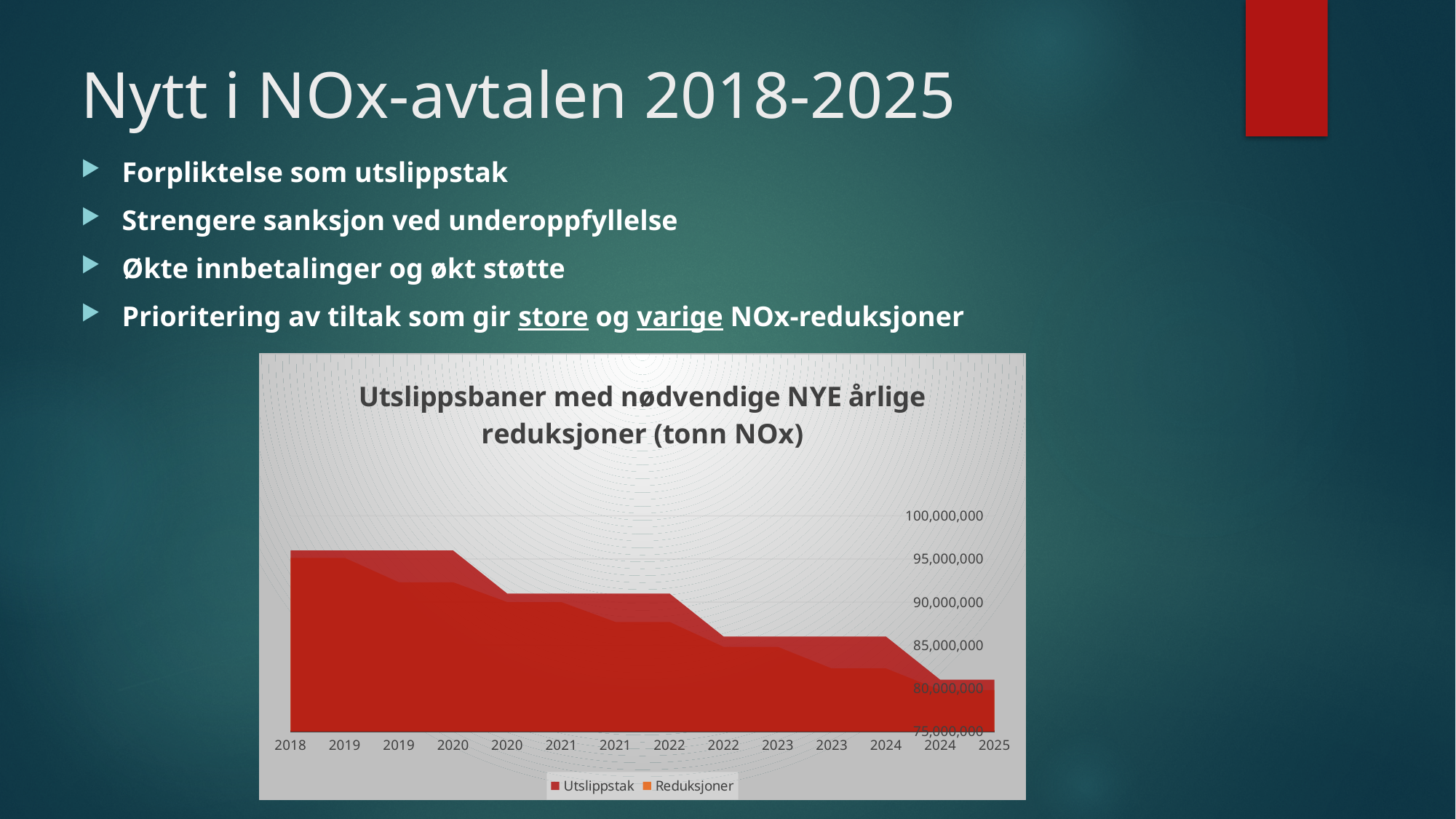
How many series does the chart legend list? 2 How many points are plotted along the x axis of the chart? 14 What is the highest value shown on the y axis of the chart? 100,000,000 Which is larger, the Utslippstak value for 2018 or for 2025? 2018 What kind of chart is shown on the slide? area chart Which year has the lowest Utslippstak value? 2024 and 2025 (tied) What are the two series named in the legend? Utslippstak and Reduksjoner Is the Utslippstak value for 2018 greater or less than 90,000,000? greater Is the Utslippstak value for 2023 greater or less than 90,000,000? less Is the Utslippstak value for 2025 greater or less than 85,000,000? less What is the title of the chart? Utslippsbaner med nødvendige NYE årlige reduksjoner (tonn NOx) Do the Utslippstak values rise or fall from 2018 to 2025? fall